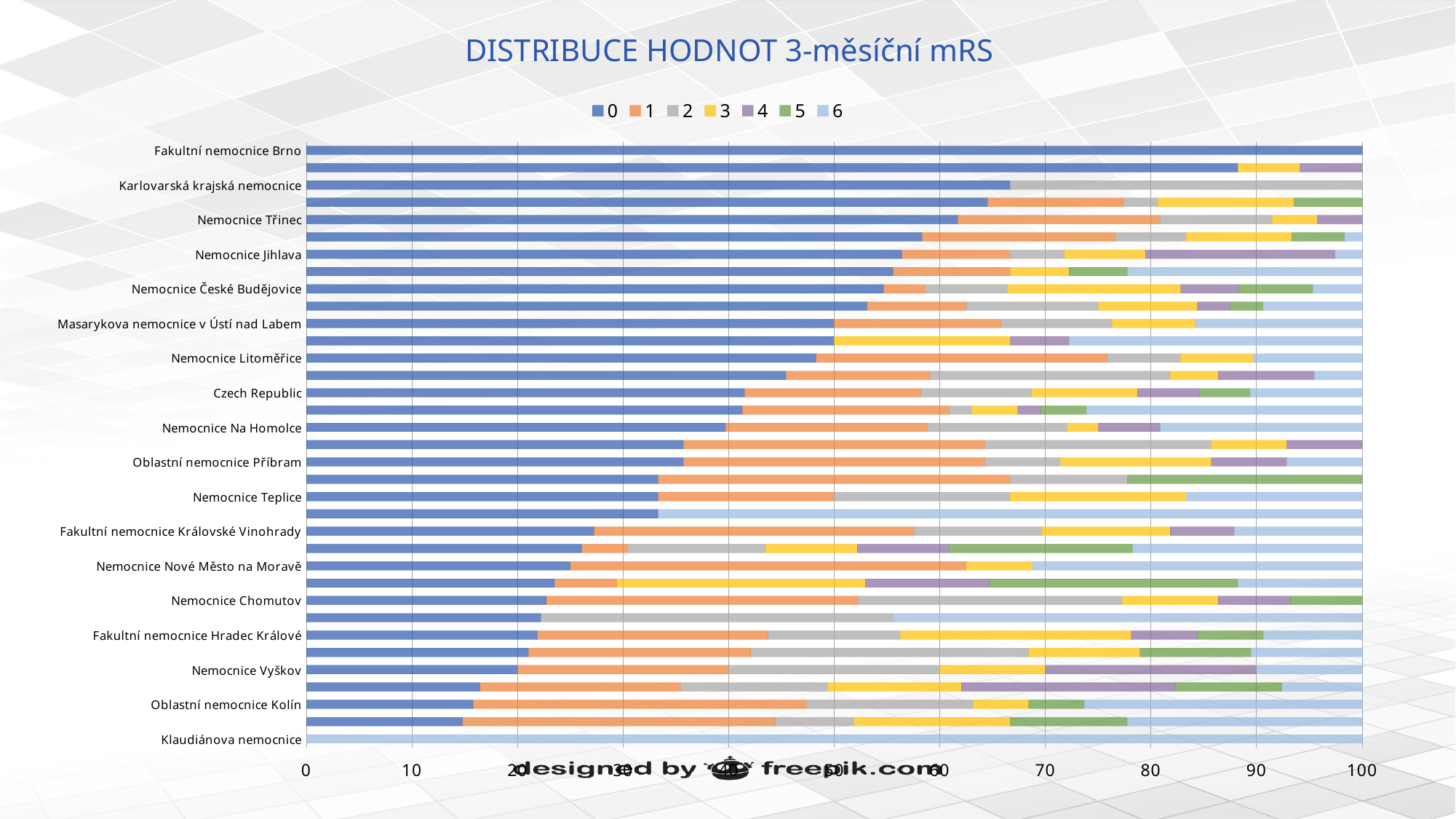
Which labelled hospital has the lowest value for series 0? Klaudiánova nemocnice Is the value of series 0 for Oblastní nemocnice Kolín greater or less than 20? less Is the value of series 0 for Karlovarská krajská nemocnice greater or less than 60? greater What is the title of the chart? DISTRIBUCE HODNOT 3-měsíční mRS Which labelled hospital has the highest value for series 0? Fakultní nemocnice Brno What kind of chart is shown on the slide? bar chart Is the value of series 0 for Nemocnice Jihlava greater or less than 50? greater How many series does the legend list? 7 What is the value of series 0 for Fakultní nemocnice Brno? 100 Which has the larger value for series 0, Karlovarská krajská nemocnice or Nemocnice Chomutov? Karlovarská krajská nemocnice What is the value of series 6 for Klaudiánova nemocnice? 100